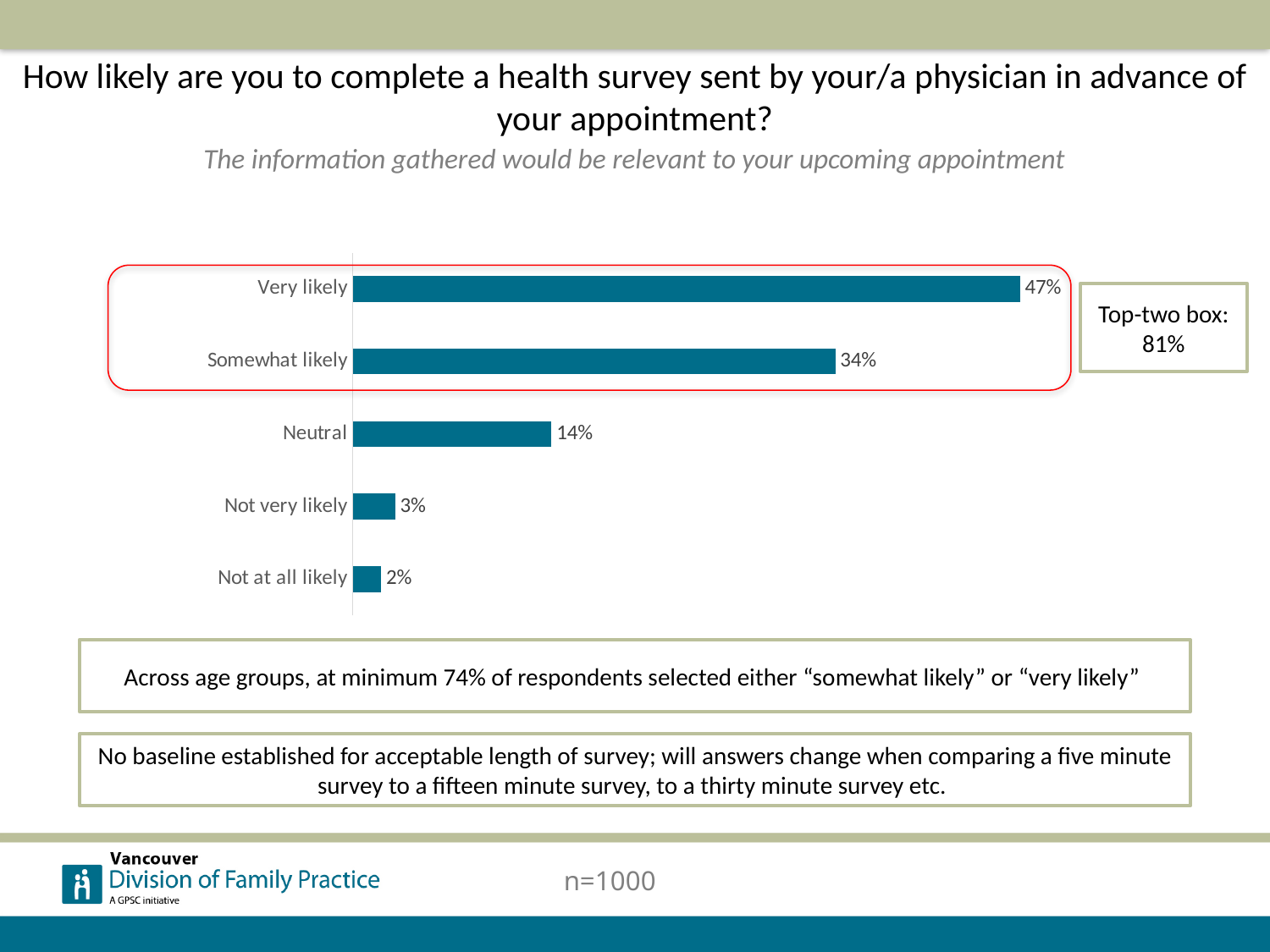
What is the value shown for the Neutral category? 14% What is the top-two box value shown in the callout next to the chart? 81% What is the difference between the Very likely and Somewhat likely values? 13% Which category has the lowest value in the chart? Not at all likely Which category has the highest value in the chart? Very likely What is the combined value of the Very likely and Somewhat likely categories? 81% Which is larger, the value for Somewhat likely or the value for Neutral? Somewhat likely What kind of chart is shown on the slide? Bar chart What is the difference between the Neutral and Not very likely values? 11% What percentage of respondents selected Not at all likely? 2% What percentage of respondents said they are very likely to complete the health survey? 47% How many categories are shown in the chart? 5